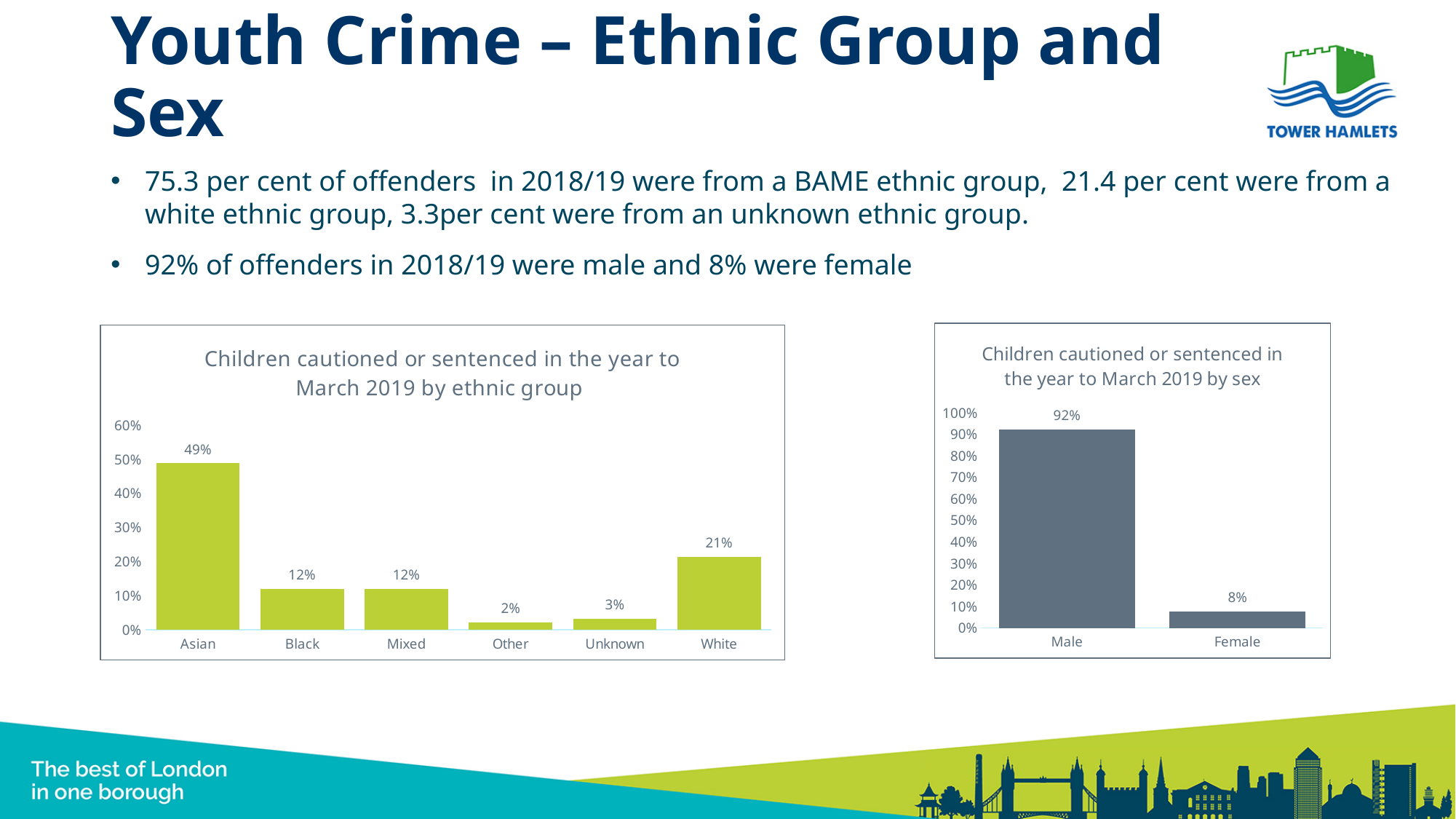
In the chart 'Children cautioned or sentenced in the year to March 2019 by ethnic group', which is larger, the value for Unknown or the value for Other? Unknown What kind of chart is 'Children cautioned or sentenced in the year to March 2019 by sex'? Bar chart In the chart 'Children cautioned or sentenced in the year to March 2019 by ethnic group', what is the value for Asian? 49% In the chart 'Children cautioned or sentenced in the year to March 2019 by ethnic group', what is the difference between the values for Asian and White? 28% In the chart 'Children cautioned or sentenced in the year to March 2019 by sex', what is the value for Female? 8% What is the title of the chart on the right of the slide? Children cautioned or sentenced in the year to March 2019 by sex In the chart 'Children cautioned or sentenced in the year to March 2019 by ethnic group', which ethnic group has the lowest value? Other In the chart 'Children cautioned or sentenced in the year to March 2019 by ethnic group', which ethnic group has the highest value? Asian In the chart 'Children cautioned or sentenced in the year to March 2019 by sex', what is the difference between the values for Male and Female? 84% In the chart 'Children cautioned or sentenced in the year to March 2019 by ethnic group', is the value for White greater or less than 30%? less In the chart 'Children cautioned or sentenced in the year to March 2019 by ethnic group', how many ethnic group categories are shown? 6 In the chart 'Children cautioned or sentenced in the year to March 2019 by ethnic group', what is the value for White? 21%